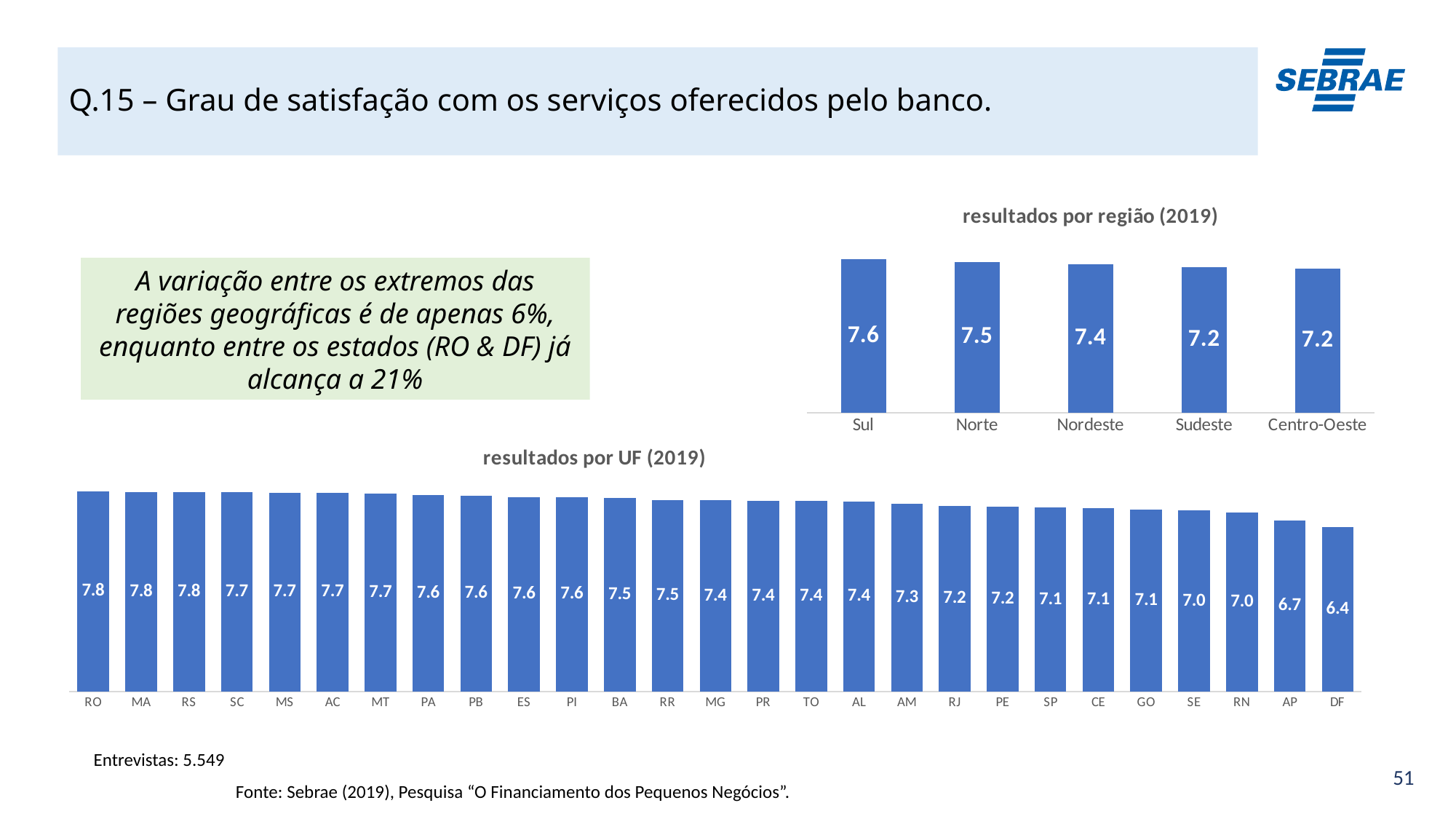
In the 'resultados por UF (2019)' chart, what is the value for AP? 6.7 In the 'resultados por UF (2019)' chart, which UF has the lowest value? DF In the 'resultados por região (2019)' chart, what is the value for Nordeste? 7.4 In the 'resultados por região (2019)' chart, which is larger, Norte or Centro-Oeste? Norte In the 'resultados por UF (2019)' chart, do the values rise or fall from left to right? fall In the 'resultados por UF (2019)' chart, how many UFs are shown? 27 In the 'resultados por região (2019)' chart, how many regions are shown? 5 What kind of chart is the 'resultados por UF (2019)' chart? bar chart In the 'resultados por UF (2019)' chart, what is the difference between RO and DF? 1.4 In the 'resultados por região (2019)' chart, which region has the highest value? Sul In the 'resultados por UF (2019)' chart, what is the value for DF? 6.4 In the 'resultados por região (2019)' chart, what is the difference between Sul and Sudeste? 0.4